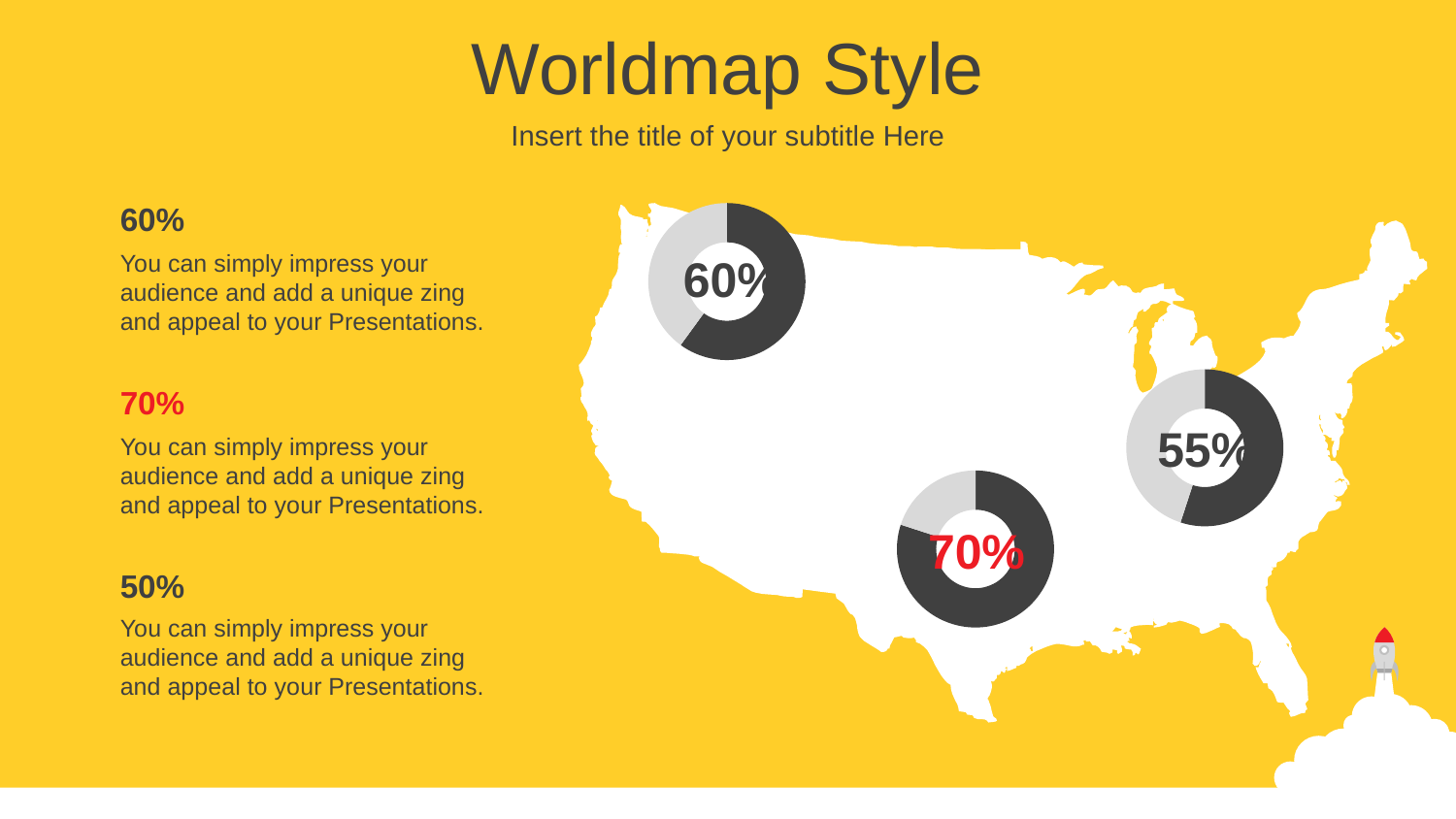
What kind of charts are placed on the map? Donut charts Which is larger, the value in the top-left donut or the value in the right donut? The top-left donut (60%) What value is shown in the donut chart at the top-left of the map? 60% Which donut chart on the map shows the lowest percentage? The right one (55%) Which donut chart on the map shows the highest percentage? The bottom-center one (70%) How many donut charts are placed on the map? 3 Which donut chart's percentage label is printed in red? The 70% donut What is the difference between the bottom-center donut (70%) and the right donut (55%)? 15 percentage points What is the difference between the top-left donut (60%) and the right donut (55%)? 5 percentage points What value is shown in the donut chart at the bottom-center of the map? 70% What value is shown in the donut chart on the right side of the map? 55%